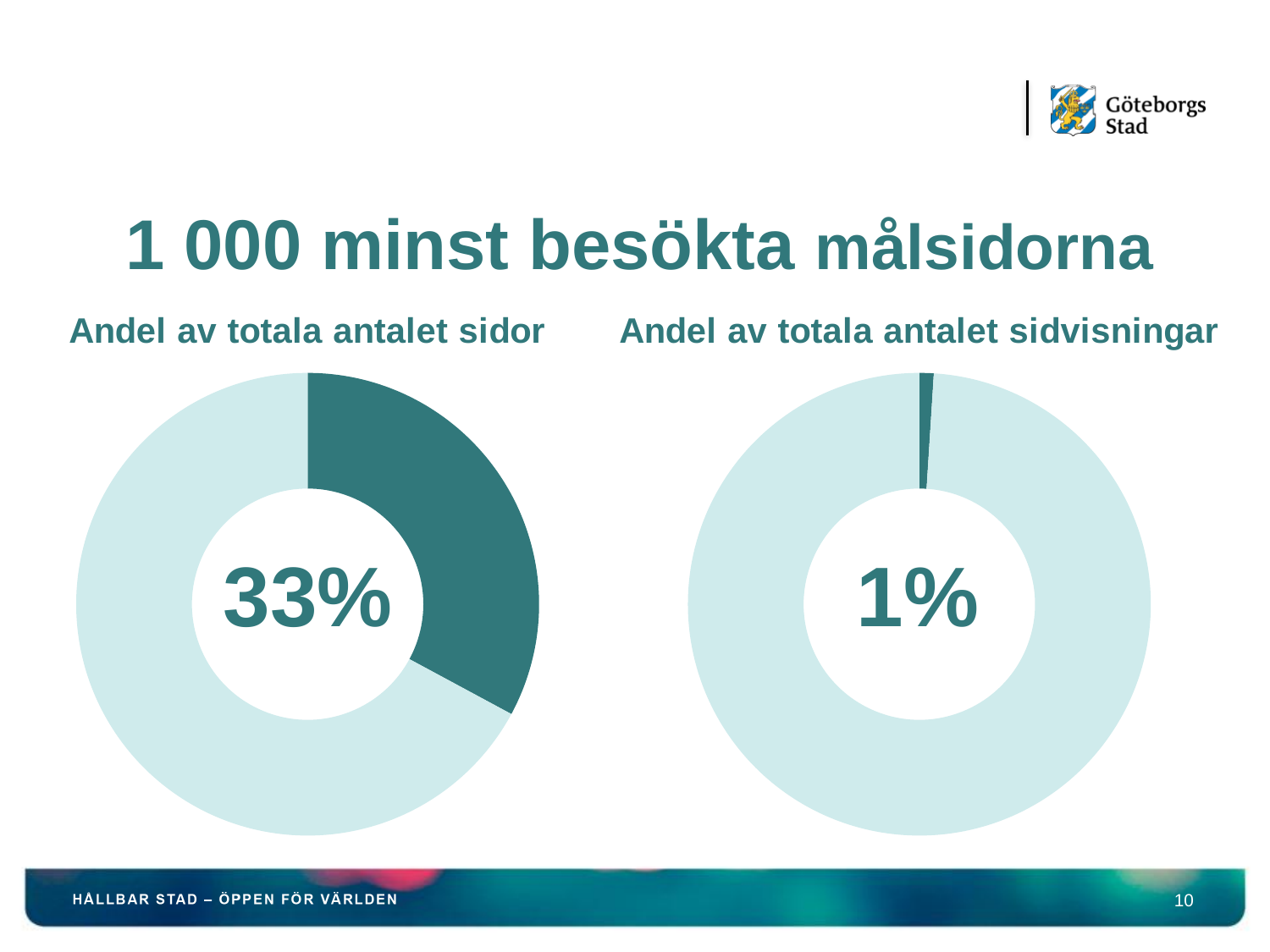
How many donut charts are shown on the slide? 2 What is the difference in percentage points between the value in the "Andel av totala antalet sidor" chart and the value in the "Andel av totala antalet sidvisningar" chart? 32 percentage points What is the title of the chart on the right side of the slide? Andel av totala antalet sidvisningar Which chart shows the larger percentage, "Andel av totala antalet sidor" or "Andel av totala antalet sidvisningar"? Andel av totala antalet sidor What is the main title of the slide above the two charts? 1 000 minst besökta målsidorna What kind of chart is used on the right side of the slide under "Andel av totala antalet sidvisningar"? Donut (pie) chart In the chart titled "Andel av totala antalet sidvisningar", what share of the donut does the dark teal slice represent? 1% In the chart titled "Andel av totala antalet sidvisningar", is the highlighted value greater or less than 10%? less In the chart titled "Andel av totala antalet sidvisningar", what percentage is shown in the centre of the donut? 1% In the chart titled "Andel av totala antalet sidor", what share of the donut does the dark teal slice represent? 33% What kind of chart is used on the left side of the slide under "Andel av totala antalet sidor"? Donut (pie) chart In the chart titled "Andel av totala antalet sidor", what percentage is shown in the centre of the donut? 33%